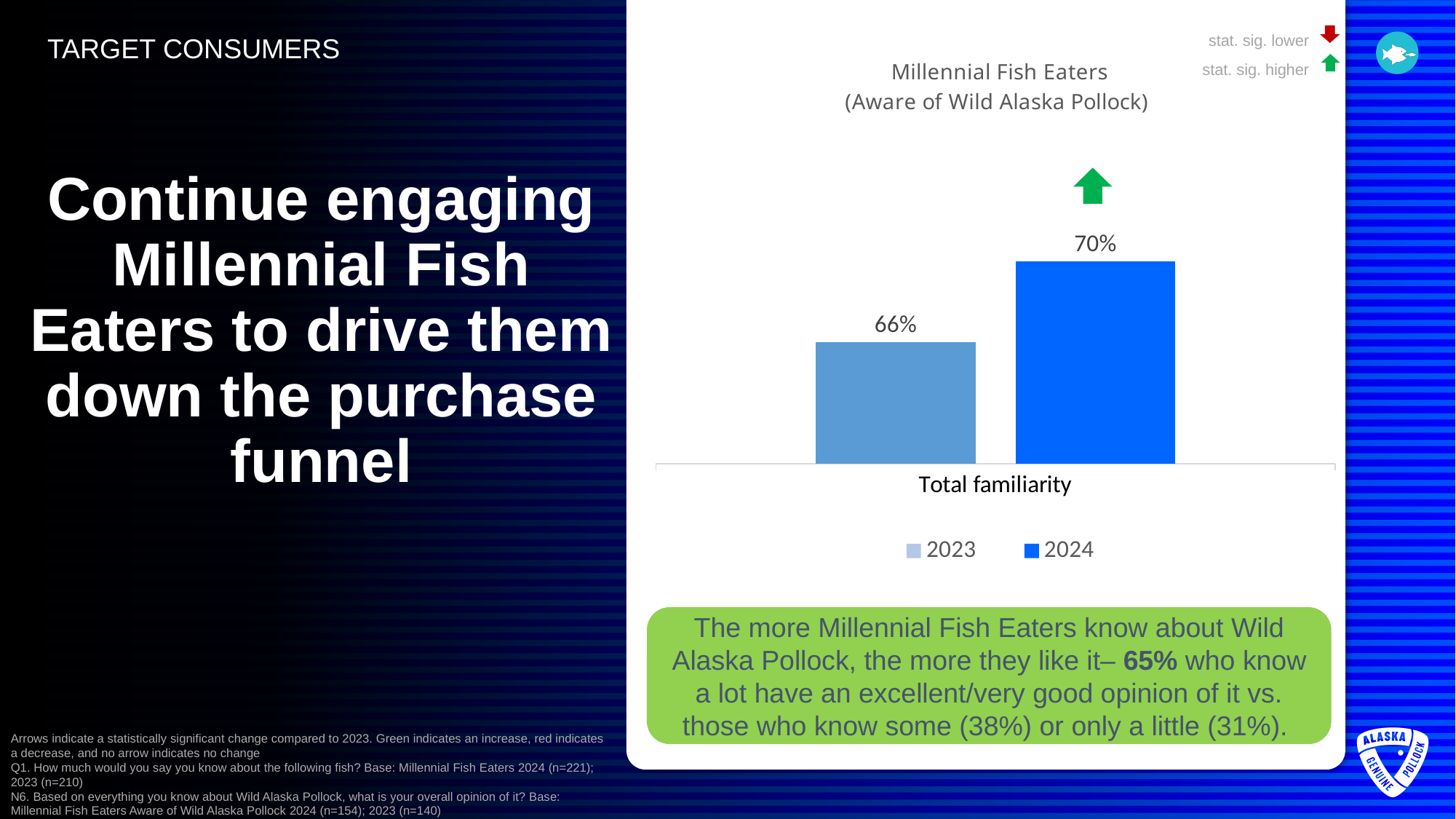
What is the Total familiarity value for 2023? 66% How many categories are shown on the x axis? 1 What is the Total familiarity value for 2024? 70% Did Total familiarity rise or fall from 2023 to 2024? rise What is the difference between the 2024 and 2023 Total familiarity values? 4 percentage points What does the green arrow above the 2024 bar indicate? stat. sig. higher Which year has the higher Total familiarity value? 2024 What kind of chart is shown on the slide? bar chart Which year has the lower Total familiarity value? 2023 What is the title of the chart? Millennial Fish Eaters (Aware of Wild Alaska Pollock) Is the 2023 Total familiarity value larger or smaller than the 2024 value? smaller How many series does the legend list? 2